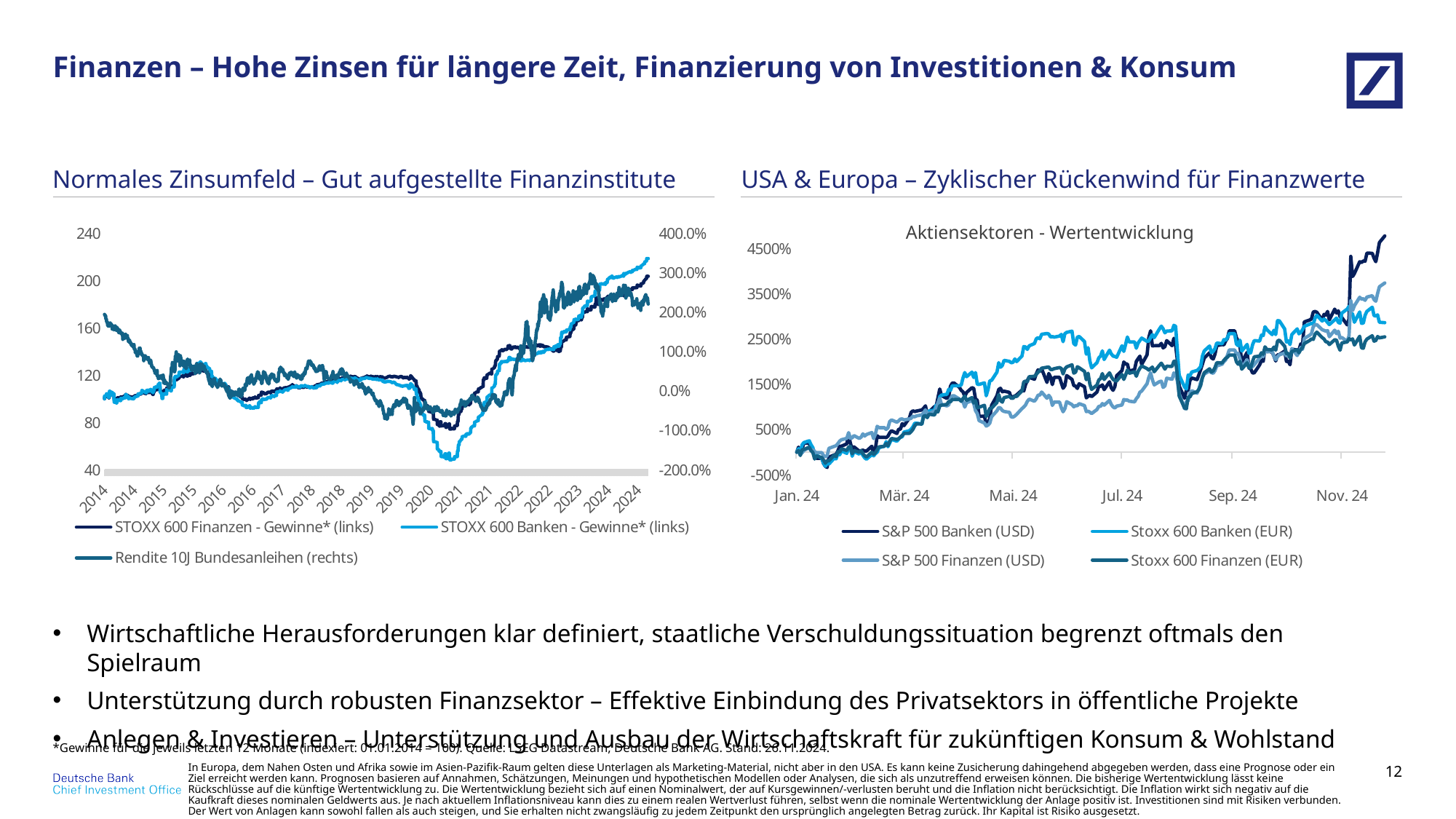
In the left chart, does the STOXX 600 Banken - Gewinne* (links) series rise or fall overall from 2014 to 2024? rise In the right chart 'Aktiensektoren - Wertentwicklung', does the S&P 500 Banken (USD) series rise or fall overall from Jan. 24 to Nov. 24? rise In the right chart 'Aktiensektoren - Wertentwicklung', is the final value of S&P 500 Banken (USD) greater or less than 3500%? greater What is the title of the right chart? Aktiensektoren - Wertentwicklung In the right chart 'Aktiensektoren - Wertentwicklung', is the final value of Stoxx 600 Finanzen (EUR) greater or less than 3500%? less What kind of chart is the chart titled 'Aktiensektoren - Wertentwicklung' on the right? line chart How many series does the legend of the left chart list? 3 What kind of chart is the left chart under 'Normales Zinsumfeld – Gut aufgestellte Finanzinstitute'? line chart How many series does the legend of the right chart 'Aktiensektoren - Wertentwicklung' list? 4 In the left chart, is the final value of STOXX 600 Banken - Gewinne* (links) greater or less than 200? greater In the left chart, at the end of 2024, which is higher: STOXX 600 Banken - Gewinne* (links) or STOXX 600 Finanzen - Gewinne* (links)? STOXX 600 Banken - Gewinne* (links) In the right chart 'Aktiensektoren - Wertentwicklung', which series ends highest at Nov. 24? S&P 500 Banken (USD)